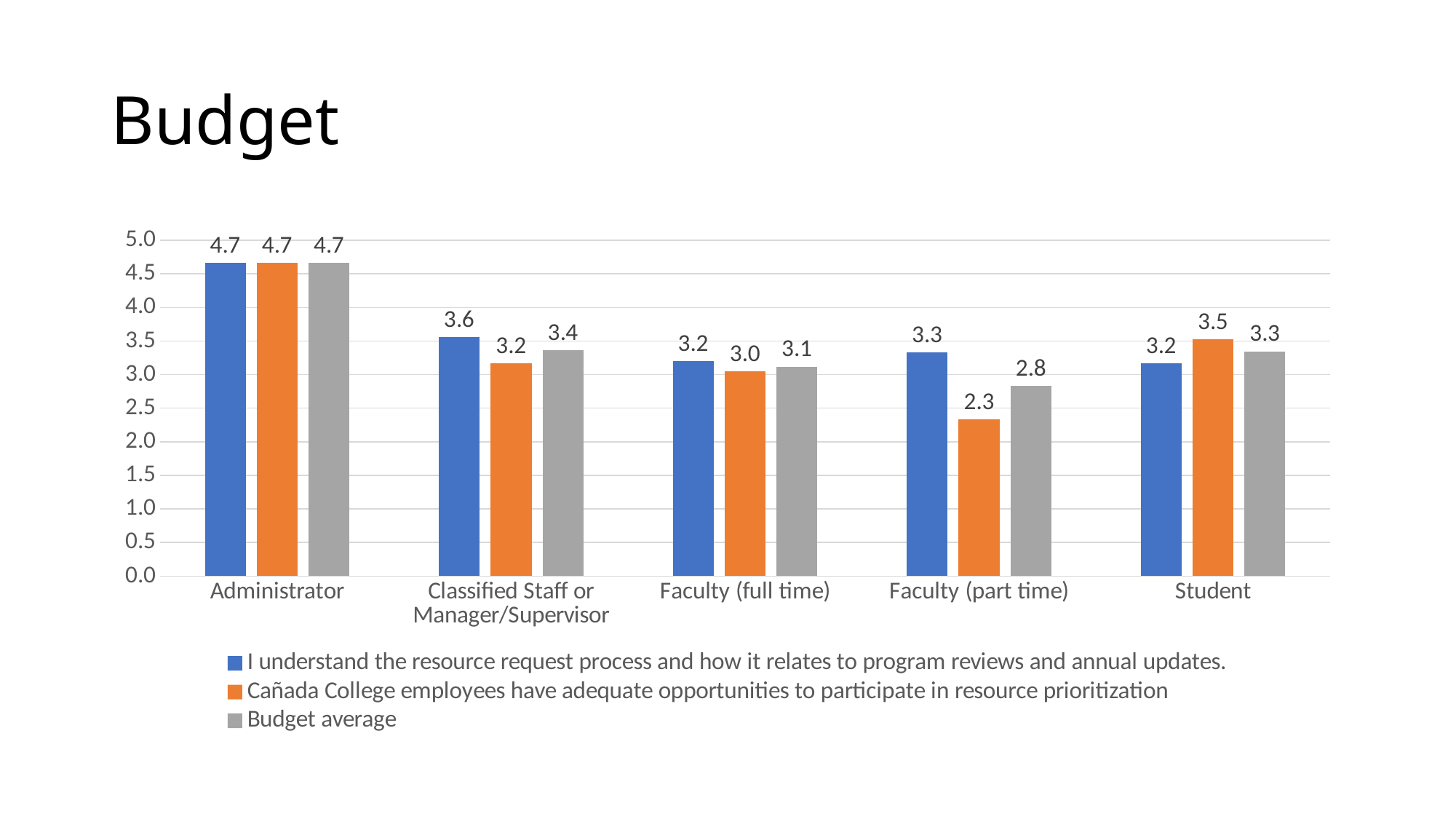
Is the Budget average for Faculty (part time) greater or less than 3.0? less Which category has the highest Budget average? Administrator What is the difference between the Administrator and Faculty (part time) values on the series 'Cañada College employees have adequate opportunities to participate in resource prioritization'? 2.4 How many series does the legend list? 3 Which category has the lowest value on the series 'Cañada College employees have adequate opportunities to participate in resource prioritization'? Faculty (part time) What is the title of the slide? Budget What is the value for Student on the series 'Cañada College employees have adequate opportunities to participate in resource prioritization'? 3.5 How many categories are shown on the x axis? 5 What is the value for Classified Staff or Manager/Supervisor on the series 'I understand the resource request process and how it relates to program reviews and annual updates.'? 3.6 What is the Budget average value for Faculty (part time)? 2.8 What kind of chart is shown on the slide? Bar chart For Faculty (part time), which is larger: the 'I understand the resource request process...' value or the 'Cañada College employees have adequate opportunities...' value? I understand the resource request process and how it relates to program reviews and annual updates.